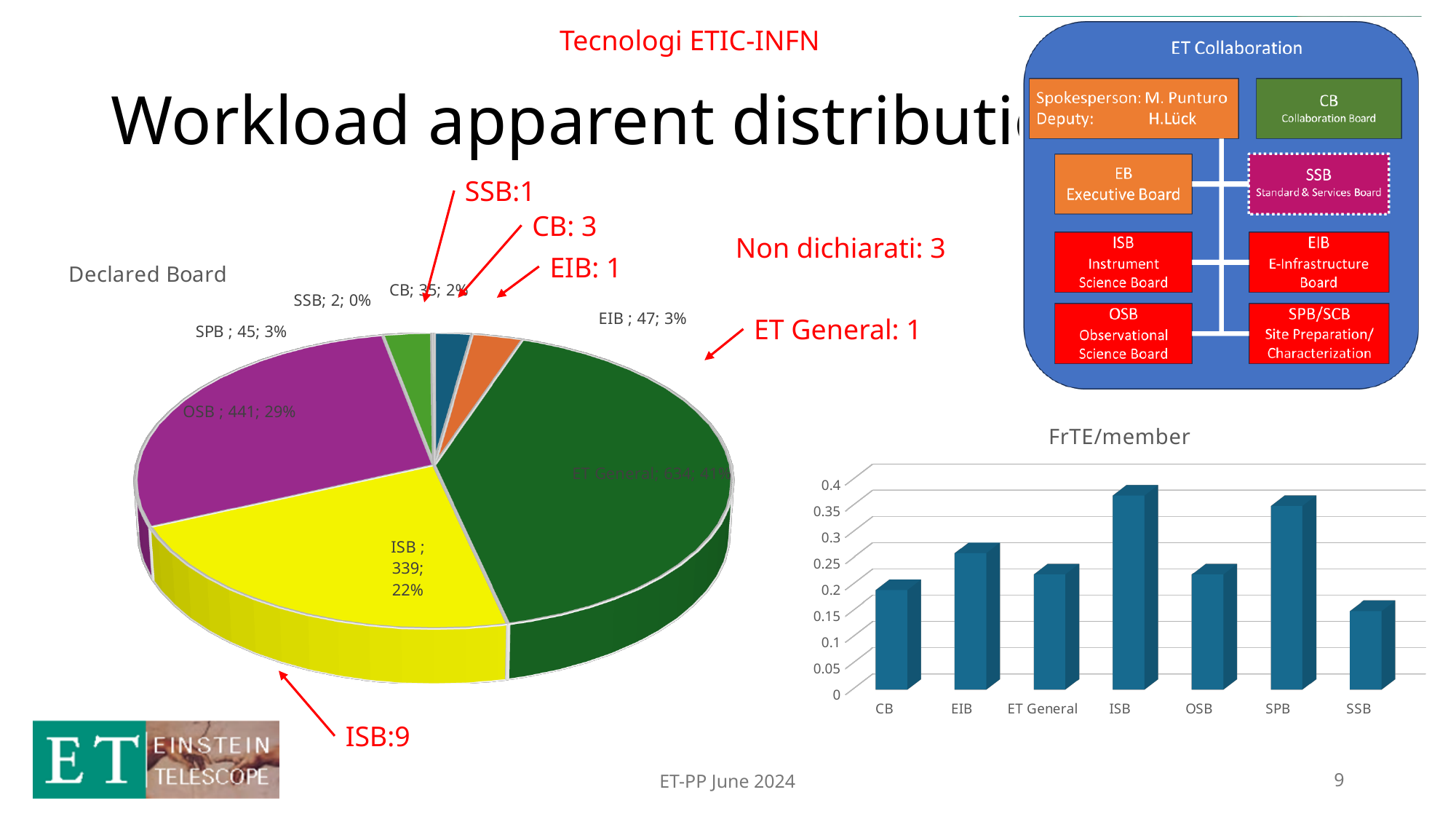
In the FrTE/member chart, is the value for CB greater or less than 0.25? less In the FrTE/member chart, which is larger, the value for EIB or the value for SSB? EIB How many slices does the Declared Board pie chart have? 7 In the FrTE/member chart, which category has the lowest bar? SSB How many categories are shown on the x axis of the FrTE/member chart? 7 In the FrTE/member chart, is the value for ISB greater or less than 0.3? greater In the Declared Board pie chart, which board has the smallest slice? SSB In the Declared Board pie chart, which board has the largest slice? ET General What kind of chart is the FrTE/member chart? bar chart In the Declared Board pie chart, what is the difference between the values for OSB and ISB? 102 In the Declared Board pie chart, what value is shown for OSB? 441 In the Declared Board pie chart, what percentage share does ET General have? 41%